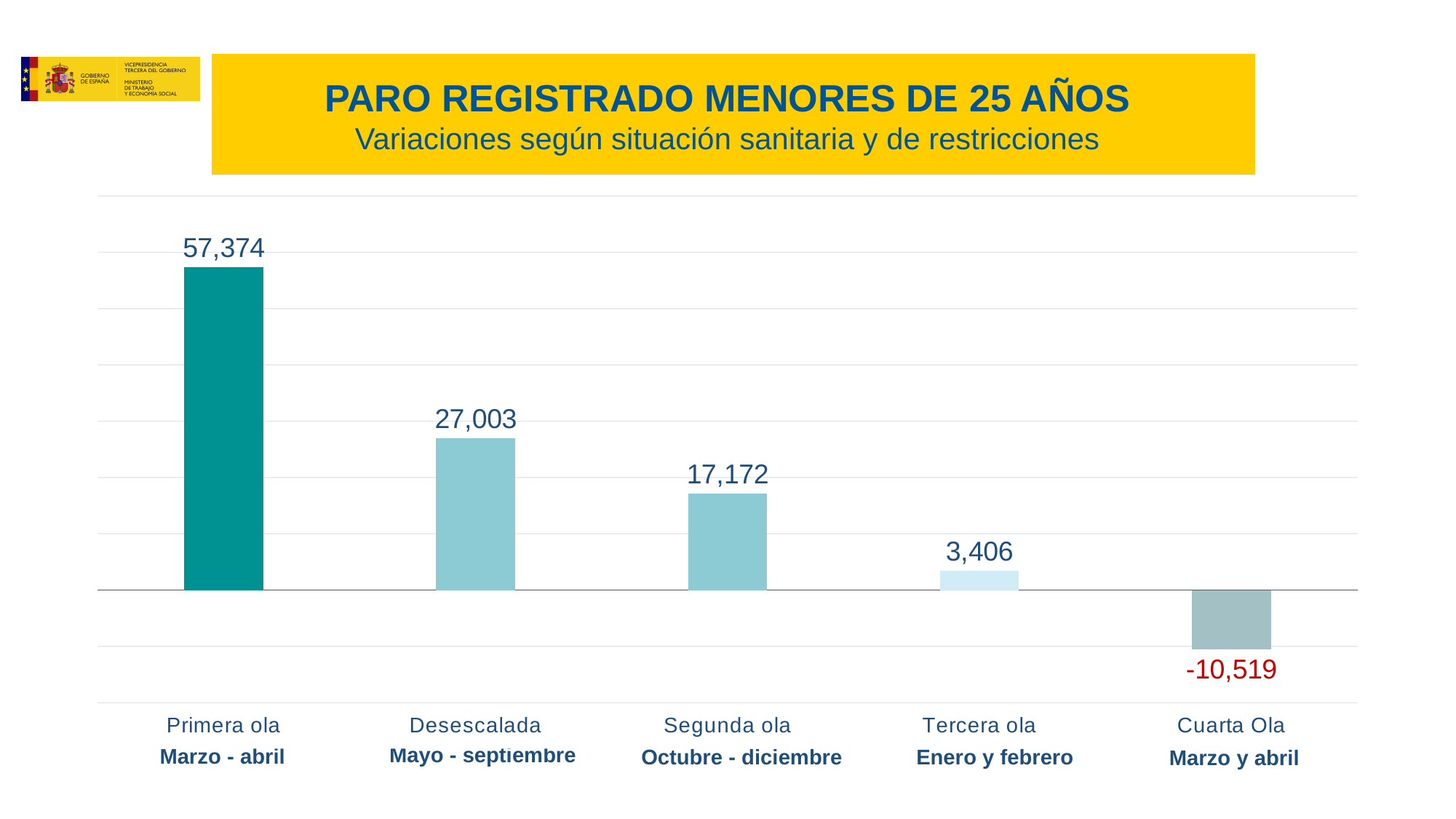
What is the value for Desescalada (Mayo - septiembre)? 27,003 What is the value for Tercera ola (Enero y febrero)? 3,406 How many categories are shown in the chart? 5 Which is larger, the value for Segunda ola or the value for Tercera ola? Segunda ola Which category has the highest value? Primera ola What is the value for Primera ola (Marzo - abril)? 57,374 Which category has the lowest value? Cuarta Ola What kind of chart is shown on the slide? Bar chart What is the value for Cuarta Ola (Marzo y abril)? -10,519 What is the value for Segunda ola (Octubre - diciembre)? 17,172 Do the values rise or fall from left to right across the categories? Fall What is the difference between the values for Primera ola and Desescalada? 30,371